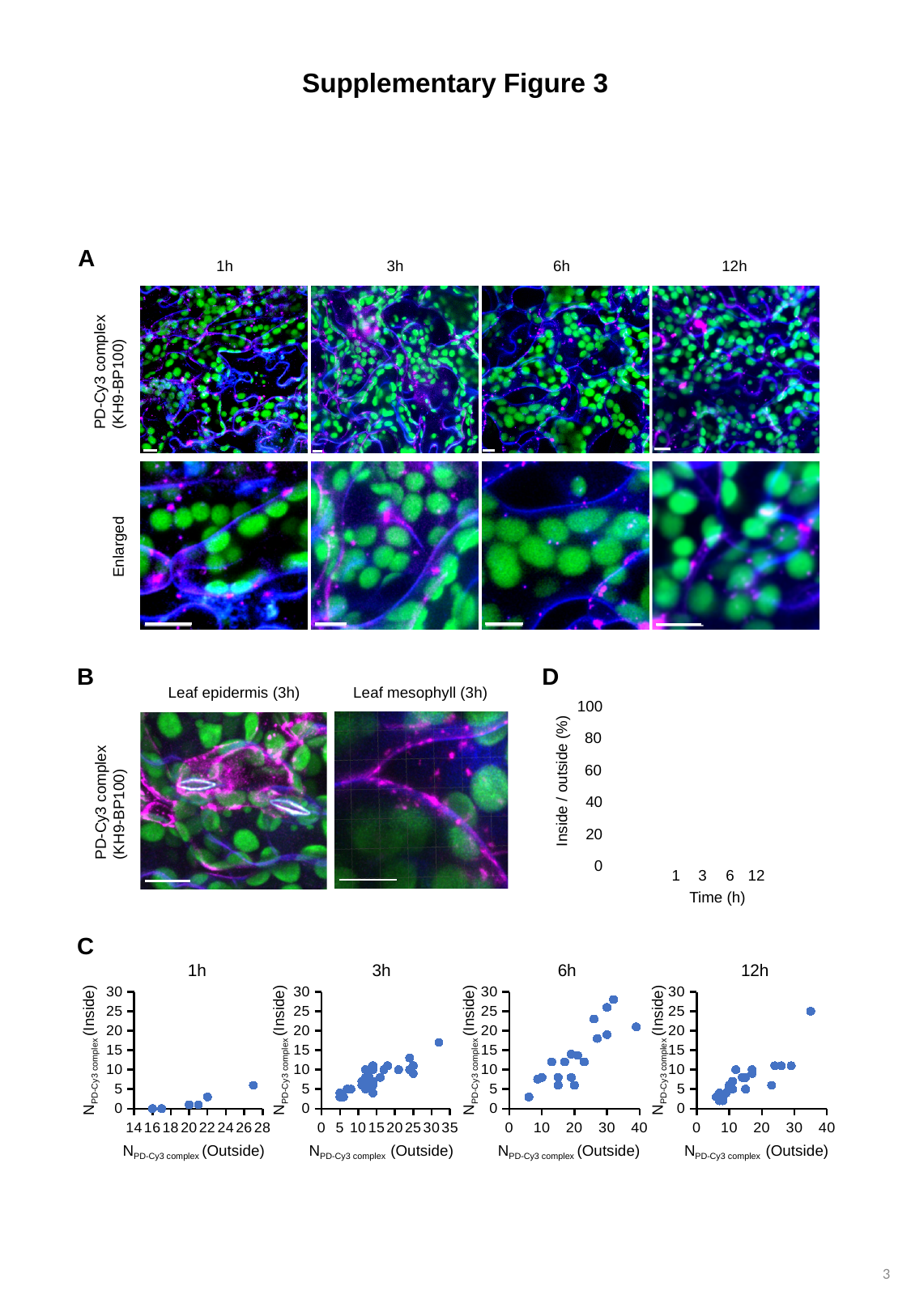
In the 6h scatter plot of panel C, do N(Inside) values tend to rise or fall as N(Outside) increases? rise In panel D, how many time points are labelled on the x axis? 4 In panel C, what are the four time points labelled above the scatter plots? 1h, 3h, 6h, 12h How many scatter plots are shown in panel C? 4 In the 6h scatter plot of panel C, is the highest N(Inside) value greater or less than 25? greater In the 12h scatter plot of panel C, is the highest N(Inside) value greater or less than 20? greater What is the y-axis label of the chart in panel D? Inside / outside (%) What kind of chart is used in panel C? scatter plot In the 3h scatter plot of panel C, is the highest N(Inside) value greater or less than 15? greater In panel C, is the highest N(Inside) value in the 6h plot larger or smaller than the highest N(Inside) value in the 1h plot? larger Which scatter plot in panel C has the lowest maximum N(Inside) value? 1h